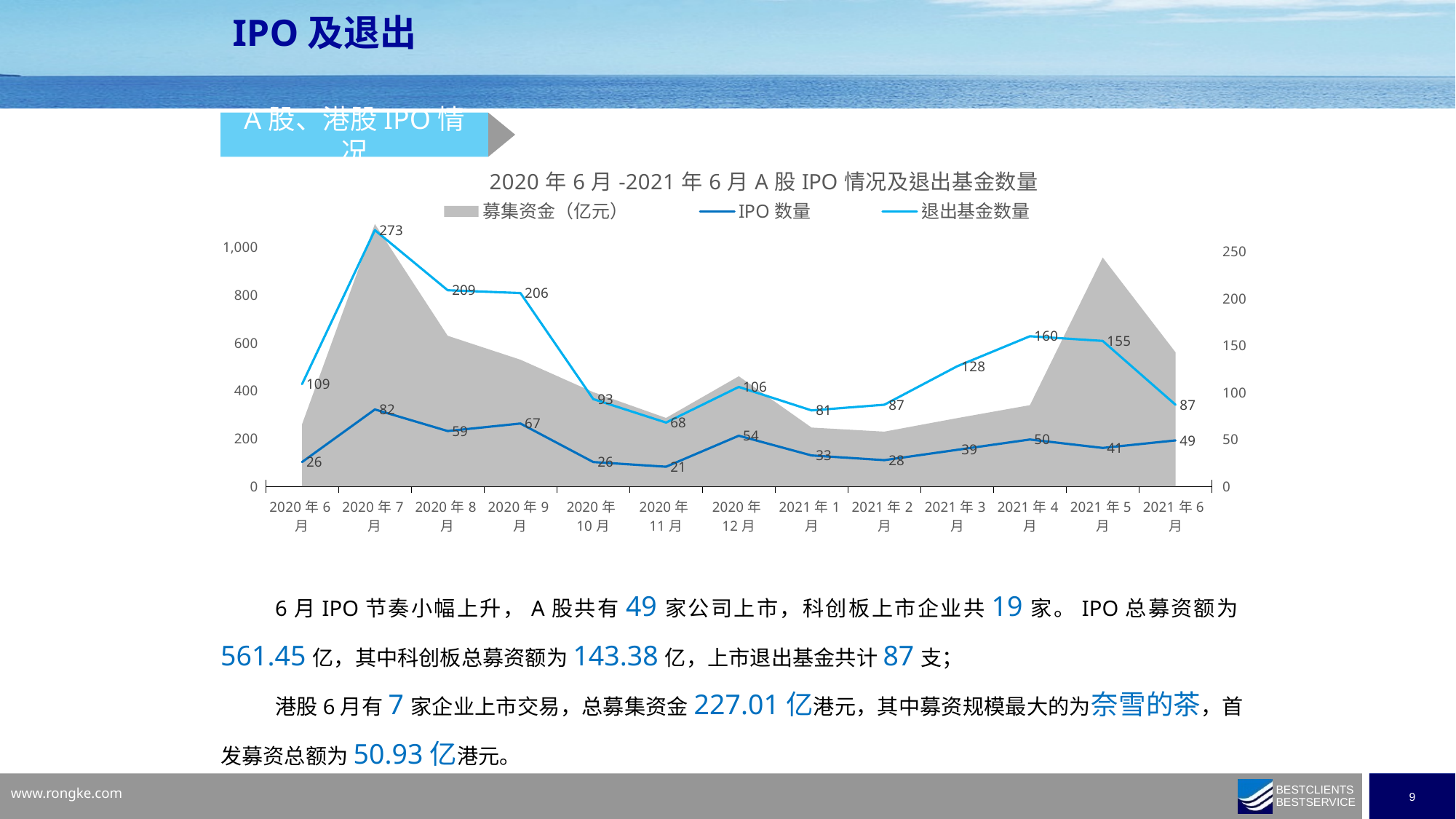
What is the IPO 数量 value for 2020 年 7 月? 82 How many months are shown on the x axis of the chart? 13 In which month is the IPO 数量 lowest? 2020 年 11 月 In which month is the 退出基金数量 highest? 2020 年 7 月 Is the 募集资金（亿元） value for 2020 年 7 月 greater or less than 800? greater What is the 退出基金数量 value for 2021 年 6 月? 87 How many series does the chart's legend list? 3 What is the difference between the 退出基金数量 values for 2020 年 7 月 and 2020 年 8 月? 64 What is the 退出基金数量 value for 2021 年 4 月? 160 Does the 退出基金数量 rise or fall from 2021 年 1 月 to 2021 年 4 月? rise Is the 募集资金（亿元） value for 2020 年 11 月 greater or less than 400? less Which month has the larger IPO 数量, 2021 年 5 月 or 2021 年 6 月? 2021 年 6 月